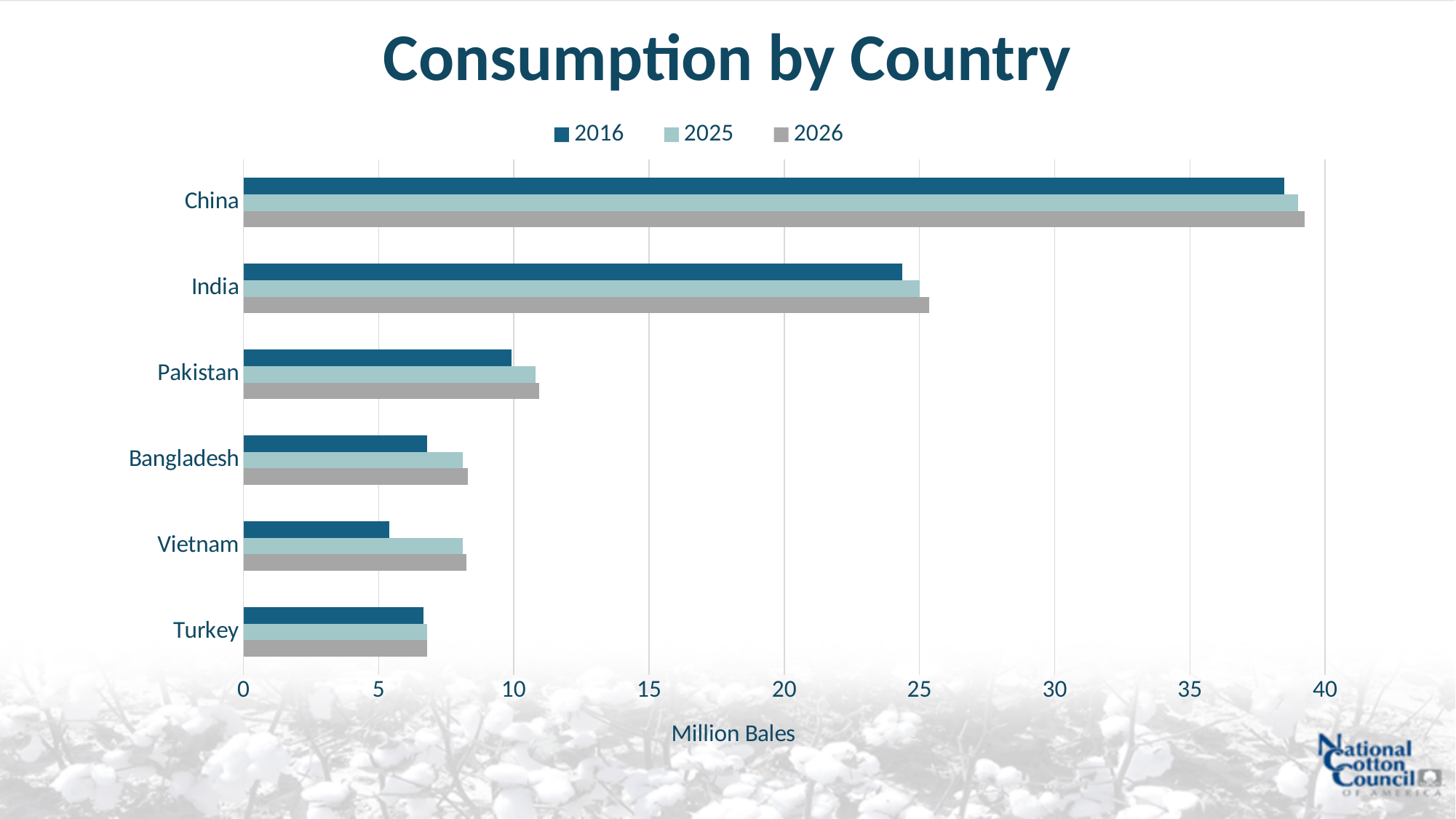
Is the 2026 value for Vietnam greater or less than 5? greater How many series does the legend list? 3 What is the title of the chart? Consumption by Country Which country has the highest consumption in 2016? China Which country has the lowest consumption in 2016? Vietnam What kind of chart is shown on the slide? bar chart Is the 2016 value for China greater or less than 35? greater Is the 2016 value for India greater or less than 25? less How many countries are shown on the chart? 6 Which is larger in 2016, the value for Pakistan or the value for Bangladesh? Pakistan What is the label on the horizontal axis? Million Bales